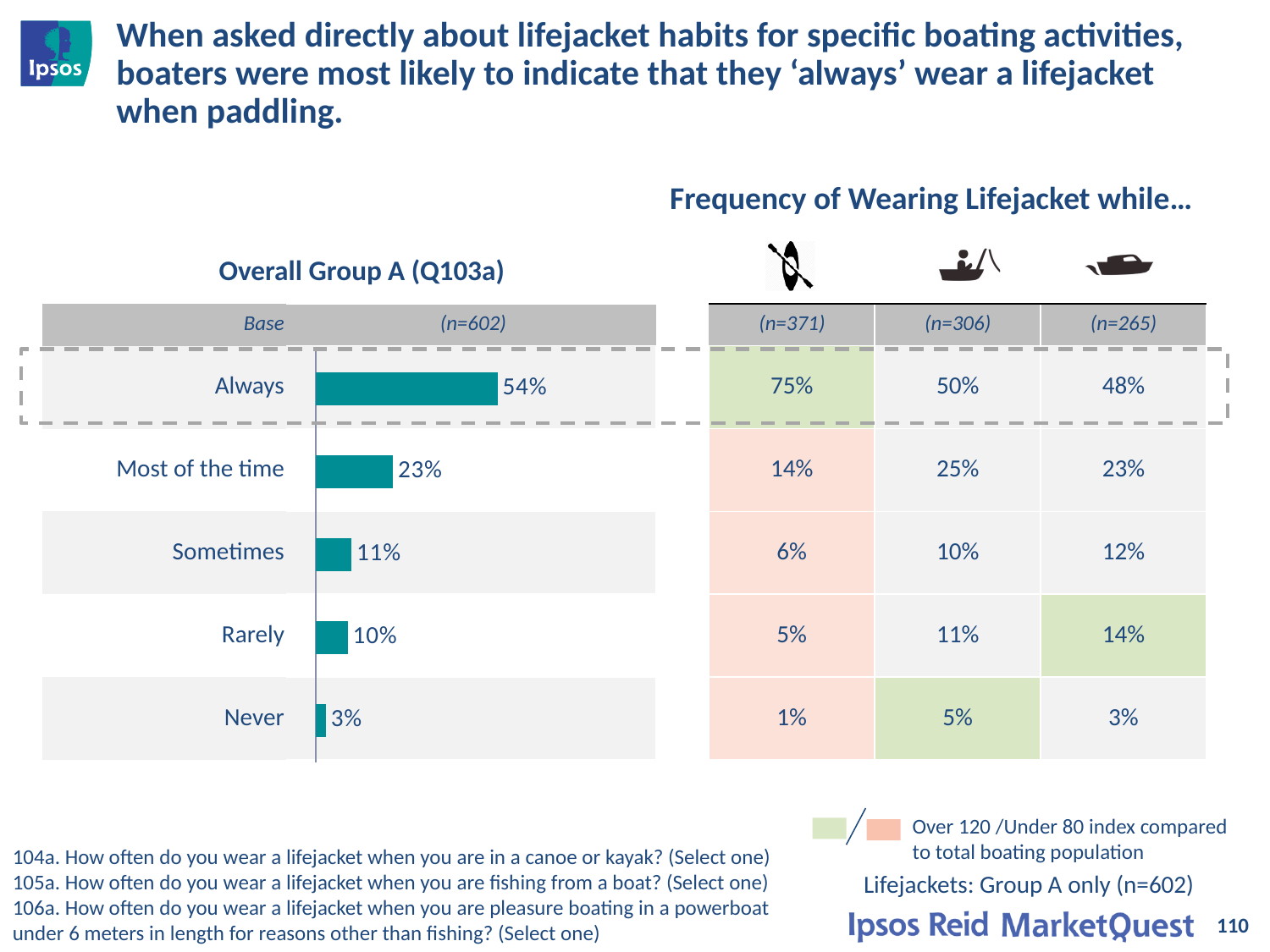
What type of chart is the Overall Group A (Q103a) chart? Bar chart Which category has the lowest value in the Overall Group A (Q103a) chart? Never In the Overall Group A (Q103a) chart, what is the value for 'Sometimes'? 11% In the Overall Group A (Q103a) chart, what is the value for 'Most of the time'? 23% How many categories are shown in the Overall Group A (Q103a) chart? 5 In the Overall Group A (Q103a) chart, what percentage of boaters said they 'Always' wear a lifejacket? 54% In the Overall Group A (Q103a) chart, which is larger: 'Most of the time' or 'Rarely'? Most of the time What is the base size (n) shown for the Overall Group A (Q103a) chart? n=602 Which category has the highest value in the Overall Group A (Q103a) chart? Always In the Overall Group A (Q103a) chart, what is the value for 'Never'? 3% In the Overall Group A (Q103a) chart, what is the difference between the 'Always' and 'Most of the time' values? 31% In the Overall Group A (Q103a) chart, what is the difference between 'Sometimes' and 'Rarely'? 1%